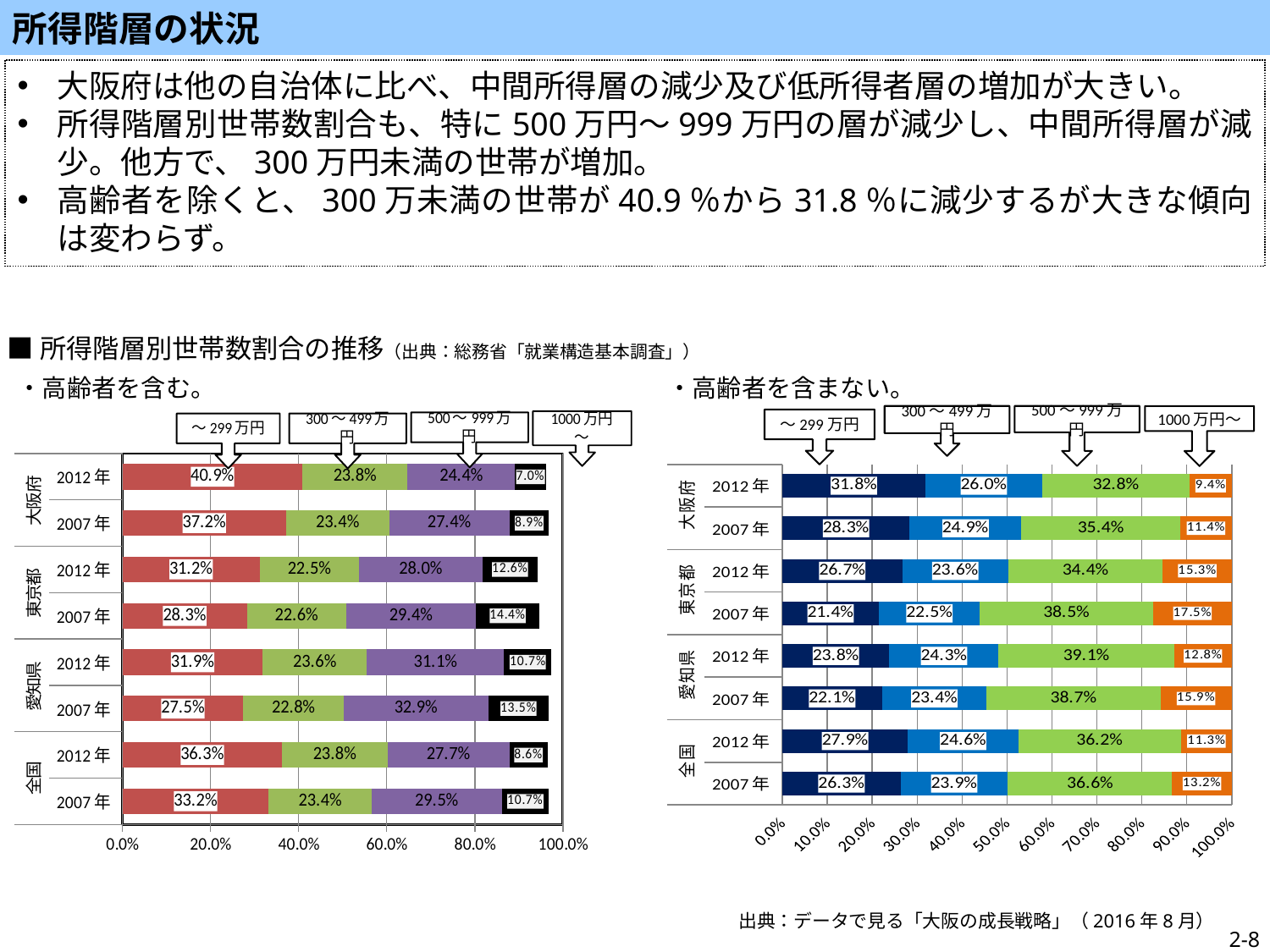
In the right chart (高齢者を含まない), which is larger: the 1000万円～ share for 東京都 in 2012年 or for 愛知県 in 2012年? 東京都 2012年 In the left chart (高齢者を含む), by how many percentage points did the ～299万円 share in 大阪府 change from 2007年 to 2012年? 3.7 percentage points In the right chart (高齢者を含まない), what is the share of households with income 300～499万円 in 全国 in 2012年? 24.6% In the right chart (高齢者を含まない), which region-year bar has the lowest share of households with income ～299万円? 東京都 2007年 In the left chart (高齢者を含む), which region-year bar has the highest share of households with income ～299万円? 大阪府 2012年 How many income-bracket series are shown in the right chart (高齢者を含まない)? 4 In the right chart (高齢者を含まない), what colour represents the 500～999万円 income bracket? Green In the right chart (高齢者を含まない), what is the share of households with income 500～999万円 in 東京都 in 2007年? 38.5% How many bars (region-year combinations) are shown in the left chart (高齢者を含む)? 8 In the left chart (高齢者を含む), what is the share of households with income ～299万円 in 大阪府 in 2012年? 40.9% In the left chart (高齢者を含む), what is the share of households with income 1000万円～ in 愛知県 in 2007年? 13.5% What type of chart is the left chart (高齢者を含む)? Stacked bar chart